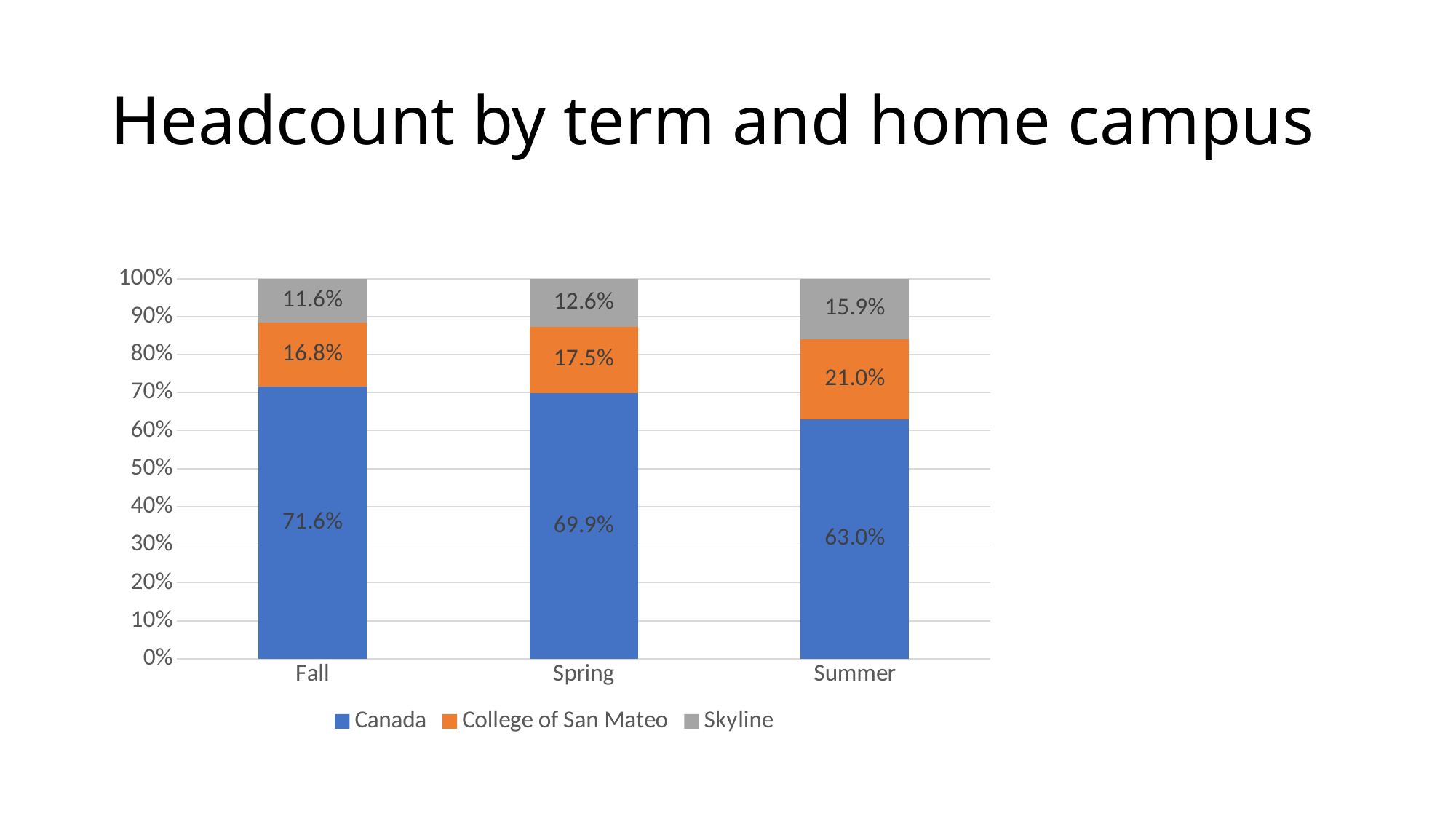
How many series does the legend list? 3 What kind of chart is shown on the slide? Stacked bar chart What is the College of San Mateo share of headcount in Summer? 21.0% What is the Canada share of headcount in Fall? 71.6% What is the difference between the Canada share in Fall and the Canada share in Summer? 8.6% In which term is the Skyline share of headcount lowest? Fall How many terms are shown on the x axis? 3 What is the Skyline share of headcount in Spring? 12.6% In which term is the Canada share of headcount highest? Fall Does the Canada share of headcount rise or fall from Fall to Summer? Fall What is the title of the chart? Headcount by term and home campus Which is larger: the College of San Mateo share in Spring or the Skyline share in Summer? College of San Mateo share in Spring